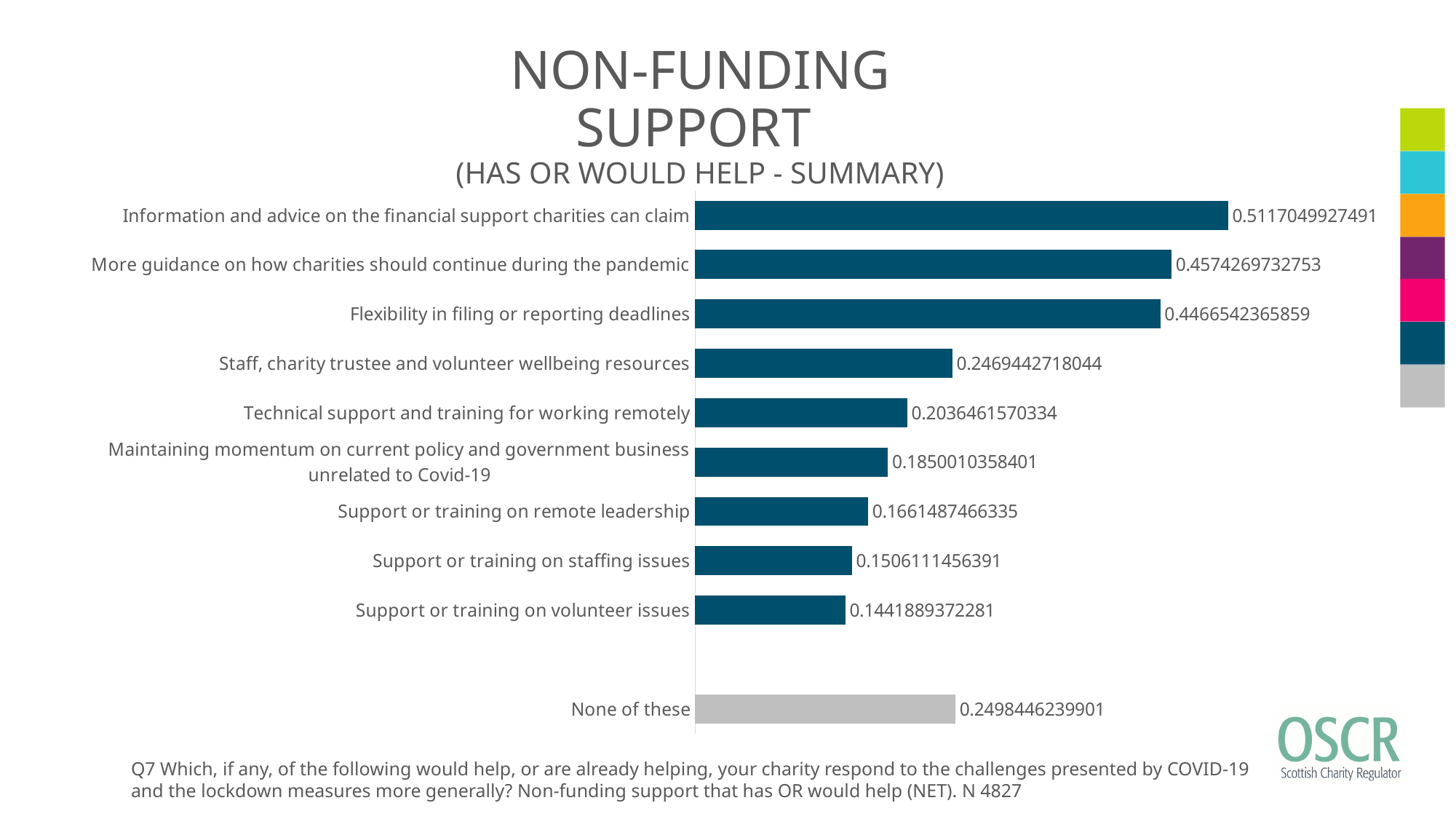
What is the value for 'None of these'? 0.2498446239901 Which is larger: the value for 'Technical support and training for working remotely' or 'Support or training on staffing issues'? Technical support and training for working remotely Which is larger: the value for 'None of these' or 'Support or training on volunteer issues'? None of these What kind of chart is shown on the slide? Bar chart Which category has the lowest value? Support or training on volunteer issues How many categories are shown in the chart? 10 What is the value for 'Support or training on remote leadership'? 0.1661487466335 What is the value for 'Flexibility in filing or reporting deadlines'? 0.4466542365859 What is the difference between the values for 'Information and advice on the financial support charities can claim' and 'More guidance on how charities should continue during the pandemic'? 0.0542780194738 Which bar is shown in a different colour (grey) from the others? None of these What is the value for 'Information and advice on the financial support charities can claim'? 0.5117049927491 Which category has the highest value? Information and advice on the financial support charities can claim